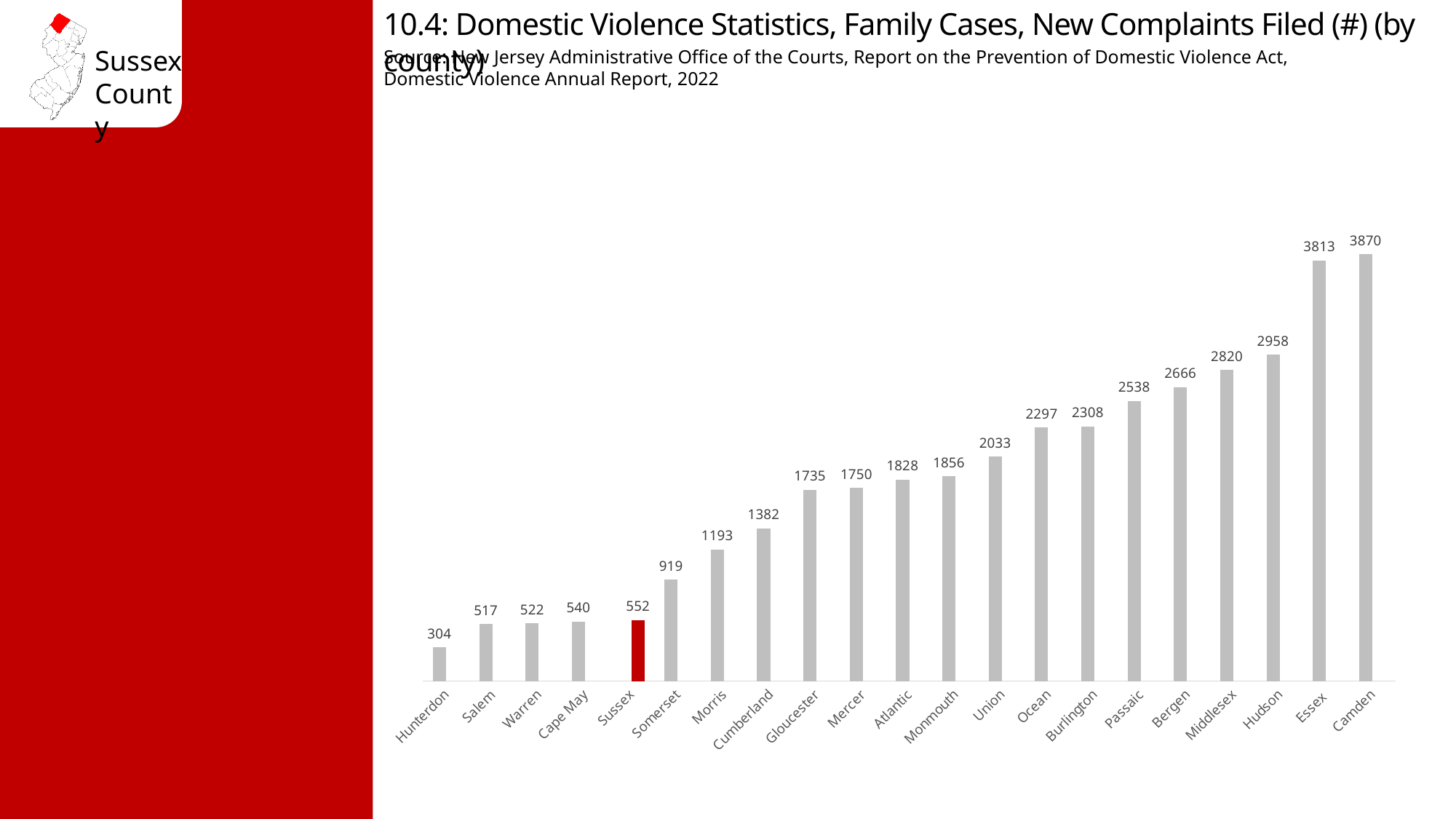
Do the values rise or fall from left to right along the x axis? Rise What is the difference between the values for Warren and Salem? 5 Which county has the lowest number of new complaints filed? Hunterdon What is the value shown for Morris? 1193 What is the number of new domestic violence complaints filed for Sussex? 552 What is the value shown for Camden? 3870 Which has a larger value, Ocean or Union? Ocean Which county has the highest number of new complaints filed? Camden Which county's bar is highlighted in red? Sussex What is the difference between the values for Essex and Sussex? 3261 What kind of chart is shown on the slide? Bar chart How many counties are shown on the chart? 21